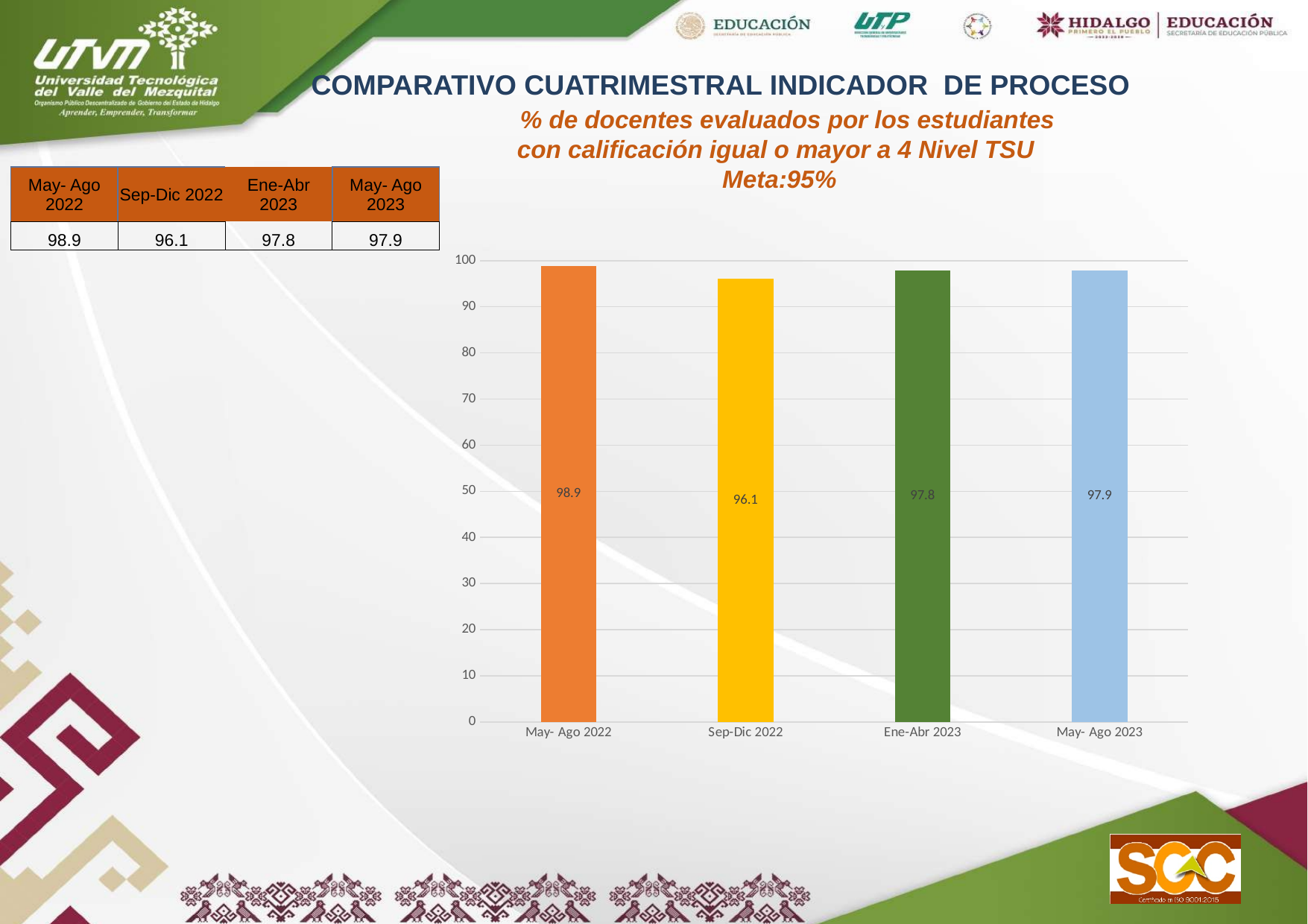
Which is larger, the value for Ene-Abr 2023 or the value for Sep-Dic 2022? Ene-Abr 2023 What kind of chart is shown on the slide? bar chart What is the value for May- Ago 2023? 97.9 What is the value for Sep-Dic 2022? 96.1 What is the target (Meta) stated in the chart title? 95% Is the value for Sep-Dic 2022 greater or less than 90? greater What is the value for Ene-Abr 2023? 97.8 How many periods are shown on the chart? 4 What is the difference between the values for May- Ago 2022 and Sep-Dic 2022? 2.8 What is the value for May- Ago 2022? 98.9 Which period has the lowest value? Sep-Dic 2022 Which period has the highest value? May- Ago 2022